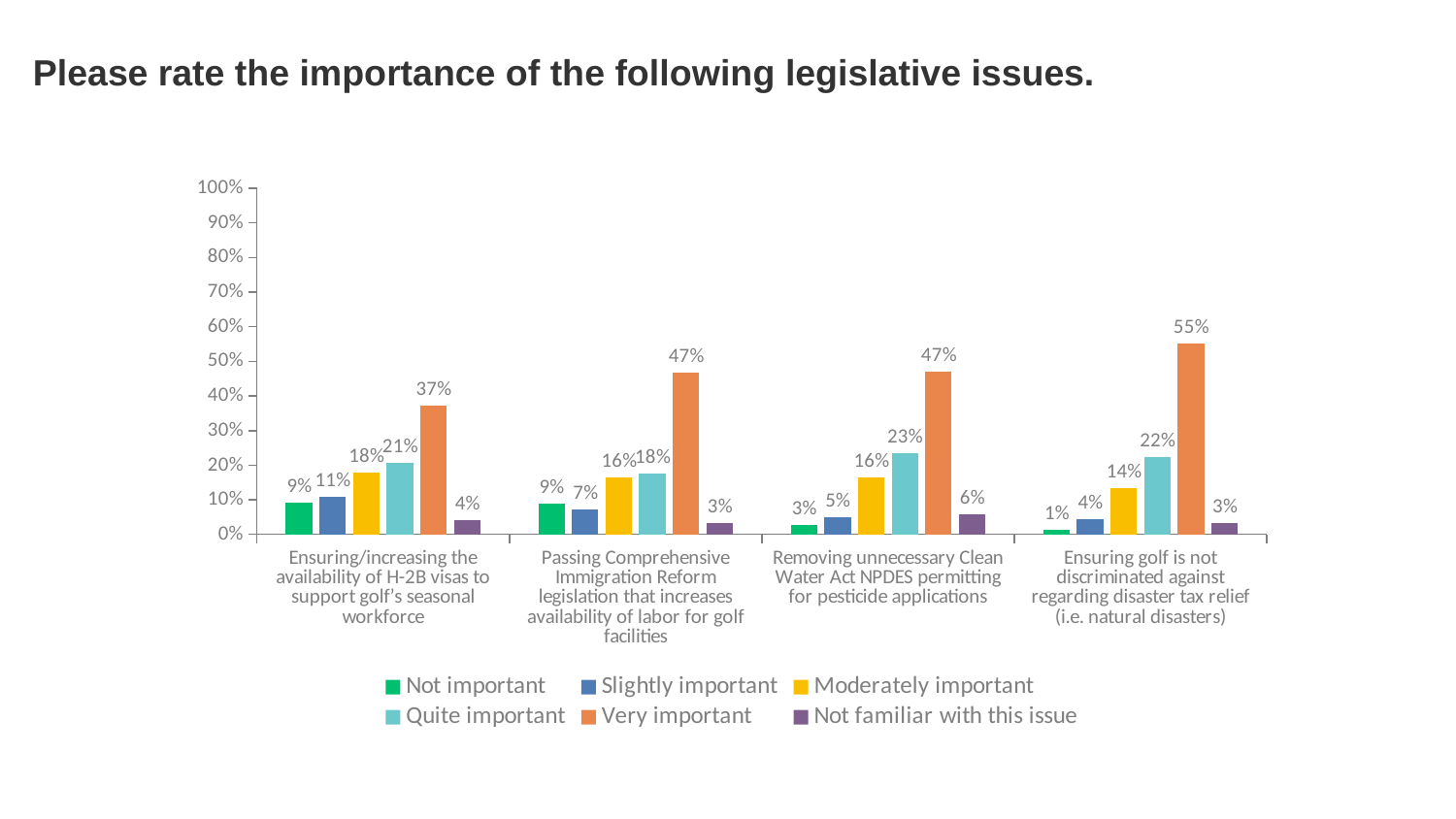
What percentage rated the disaster tax relief issue as Very important? 55% What percentage rated the H-2B visas issue as Very important? 37% What percentage rated Comprehensive Immigration Reform as Quite important? 18% Which colour represents the Very important series in the legend? Orange What kind of chart is shown on the slide? Bar chart What is the difference between the Very important percentages for the disaster tax relief issue and the H-2B visas issue? 18% How many legislative issues are shown on the x axis? 4 Which is larger: the Not familiar with this issue percentage for the Clean Water Act NPDES issue or for the H-2B visas issue? Clean Water Act NPDES permitting (6%) Which legislative issue has the highest Very important percentage? Ensuring golf is not discriminated against regarding disaster tax relief (i.e. natural disasters) What percentage rated the Clean Water Act NPDES permitting issue as Not important? 3% How many series does the legend list? 6 Which legislative issue has the lowest Not important percentage? Ensuring golf is not discriminated against regarding disaster tax relief (i.e. natural disasters)